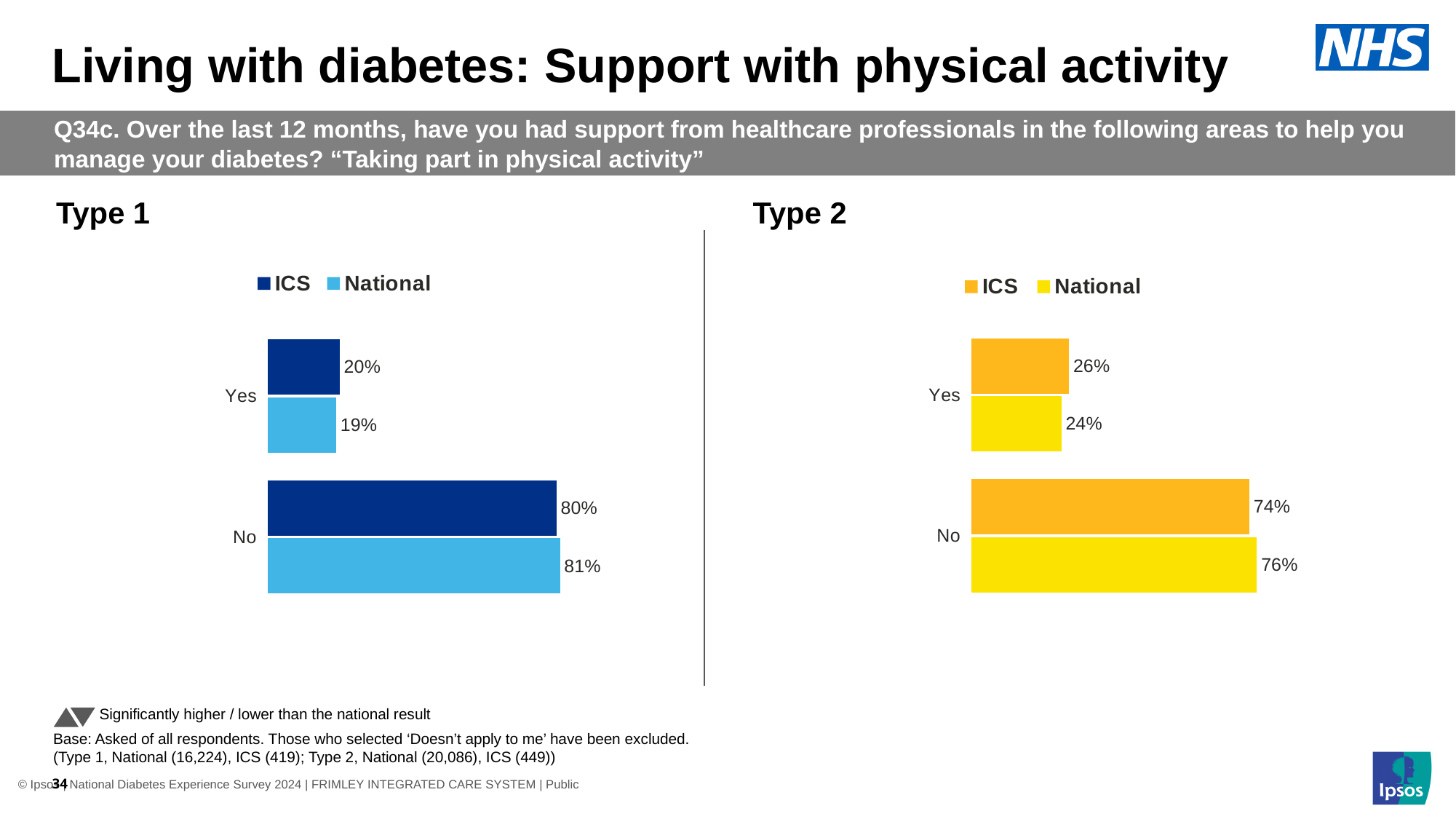
In the Type 2 chart, which category has the lowest National value? Yes How many series does the legend of the Type 1 chart list? 2 In the Type 1 chart, what is the difference between the ICS and National values for Yes? 1 percentage point In the Type 1 chart, what is the National value for No? 81% What kind of chart is the Type 1 chart? Bar chart In the Type 2 chart, what is the difference between the ICS and National values for No? 2 percentage points How many categories are shown in the Type 2 chart? 2 In the Type 2 chart, which is larger for Yes: the ICS value or the National value? ICS In the Type 1 chart, what is the ICS value for Yes? 20% In the Type 1 chart, which category has the highest ICS value? No In the Type 2 chart, what is the ICS value for Yes? 26% In the Type 2 chart, what is the National value for No? 76%